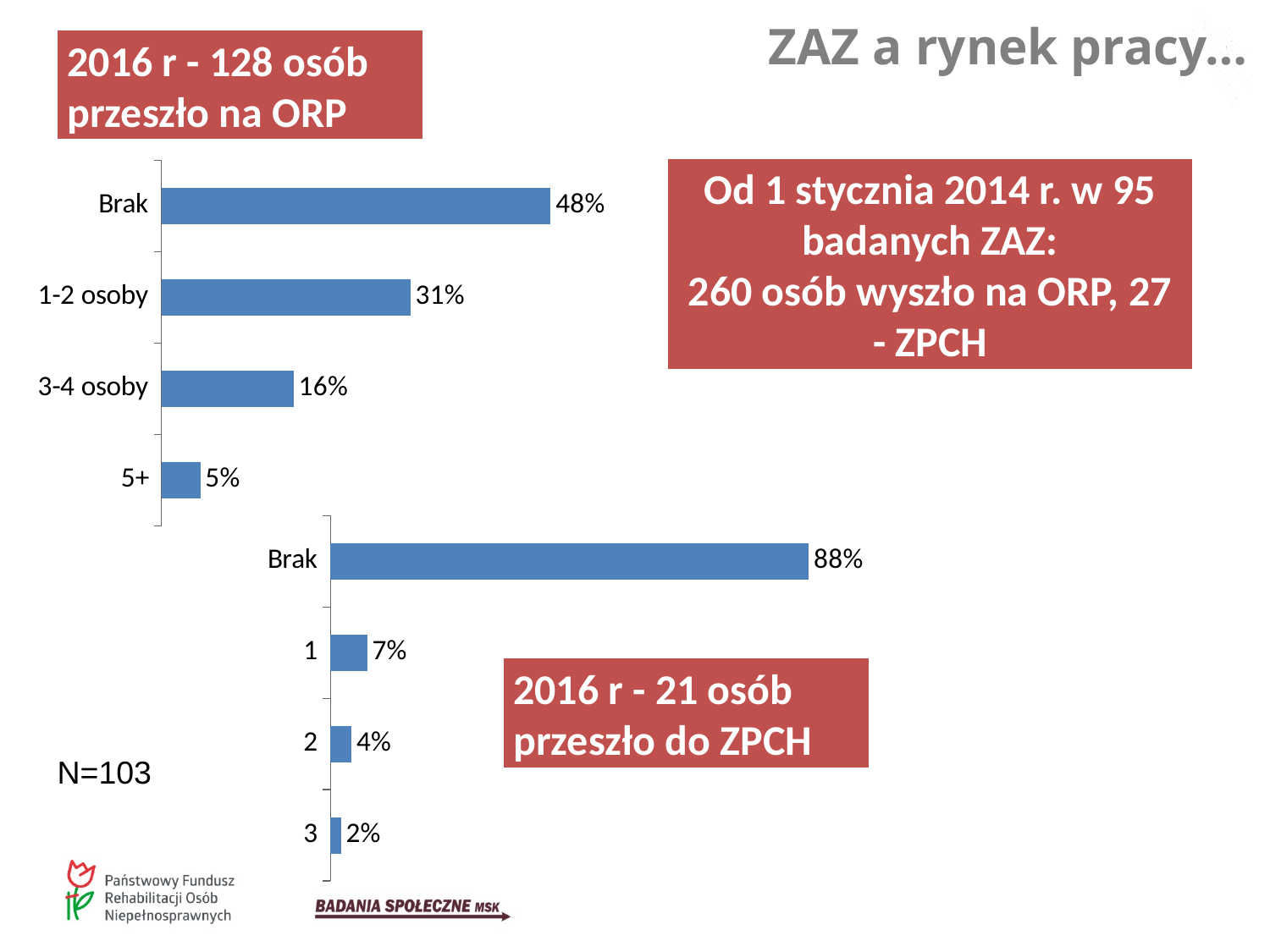
In the upper chart (2016 r - 128 osób przeszło na ORP), what is the value for 'Brak'? 48% In the lower chart (2016 r - 21 osób przeszło do ZPCH), what is the value for 'Brak'? 88% In the lower chart (2016 r - 21 osób przeszło do ZPCH), which is larger, the value for '1' or the value for '3'? 1 In the upper chart (2016 r - 128 osób przeszło na ORP), what is the value for '3-4 osoby'? 16% In the lower chart (2016 r - 21 osób przeszło do ZPCH), which category has the highest value? Brak In the upper chart (2016 r - 128 osób przeszło na ORP), which category has the lowest value? 5+ In the lower chart (2016 r - 21 osób przeszło do ZPCH), what is the difference between 'Brak' and '1'? 81% What sample size (N) is shown next to the lower chart? N=103 In the lower chart (2016 r - 21 osób przeszło do ZPCH), what is the value for '2'? 4% In the upper chart (2016 r - 128 osób przeszło na ORP), what is the difference between 'Brak' and '1-2 osoby'? 17% In the upper chart (2016 r - 128 osób przeszło na ORP), how many categories are shown? 4 What kind of chart is the lower chart (2016 r - 21 osób przeszło do ZPCH)? Bar chart